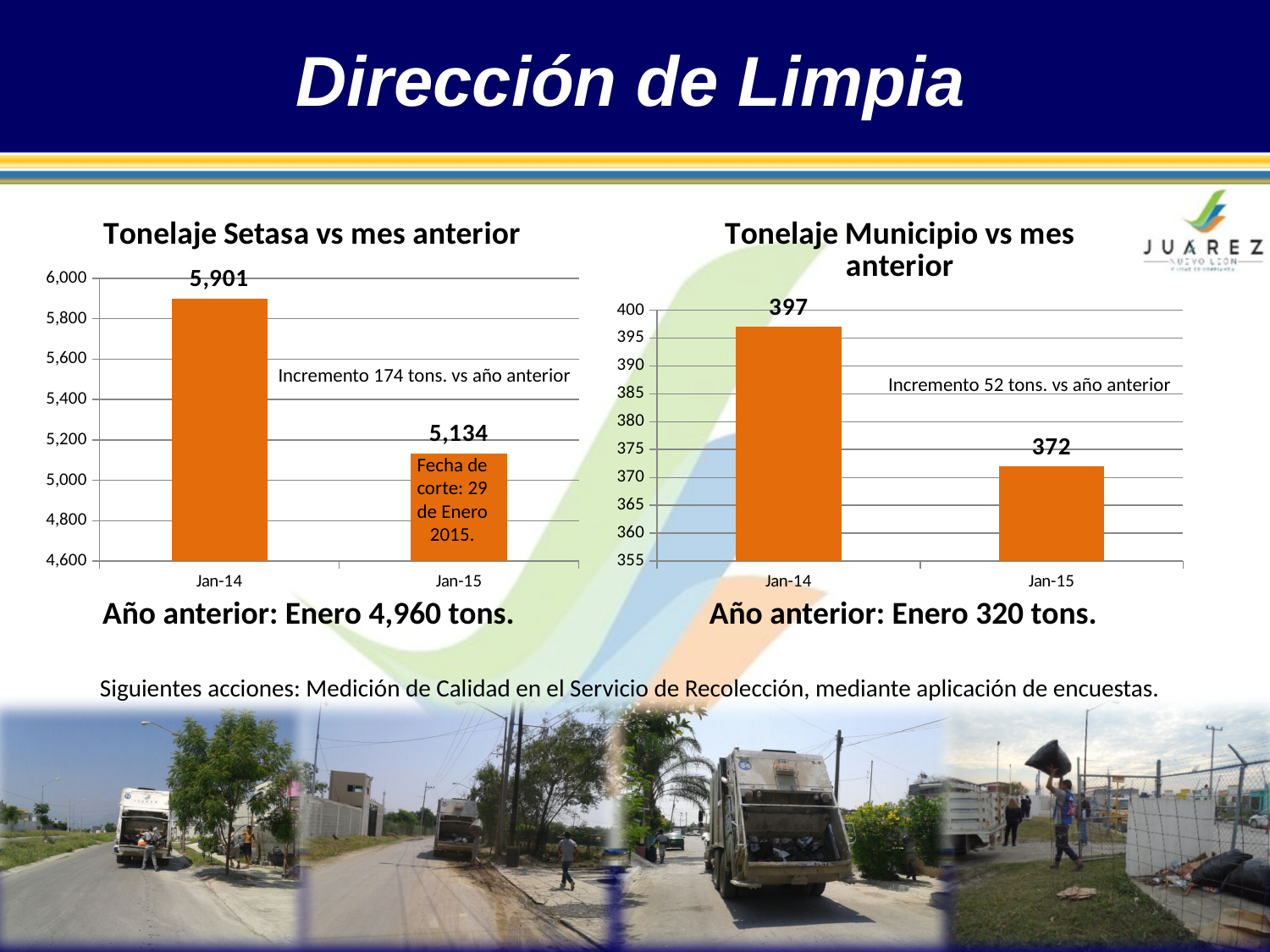
In the 'Tonelaje Municipio vs mes anterior' chart, is the value for Jan-15 greater or less than 380? less In the 'Tonelaje Setasa vs mes anterior' chart, what is the difference between the Jan-14 and Jan-15 values? 767 How many categories are shown in the 'Tonelaje Setasa vs mes anterior' chart? 2 In the 'Tonelaje Setasa vs mes anterior' chart, what is the value for Jan-14? 5,901 In the 'Tonelaje Setasa vs mes anterior' chart, which category has the highest value? Jan-14 In the 'Tonelaje Municipio vs mes anterior' chart, what is the value for Jan-15? 372 In the 'Tonelaje Setasa vs mes anterior' chart, what is the value for Jan-15? 5,134 In the 'Tonelaje Municipio vs mes anterior' chart, what is the difference between the Jan-14 and Jan-15 values? 25 What kind of chart is the 'Tonelaje Municipio vs mes anterior' chart? bar chart In the 'Tonelaje Municipio vs mes anterior' chart, what is the value for Jan-14? 397 In the 'Tonelaje Municipio vs mes anterior' chart, which category has the lowest value? Jan-15 In the 'Tonelaje Setasa vs mes anterior' chart, do the values rise or fall from Jan-14 to Jan-15? fall